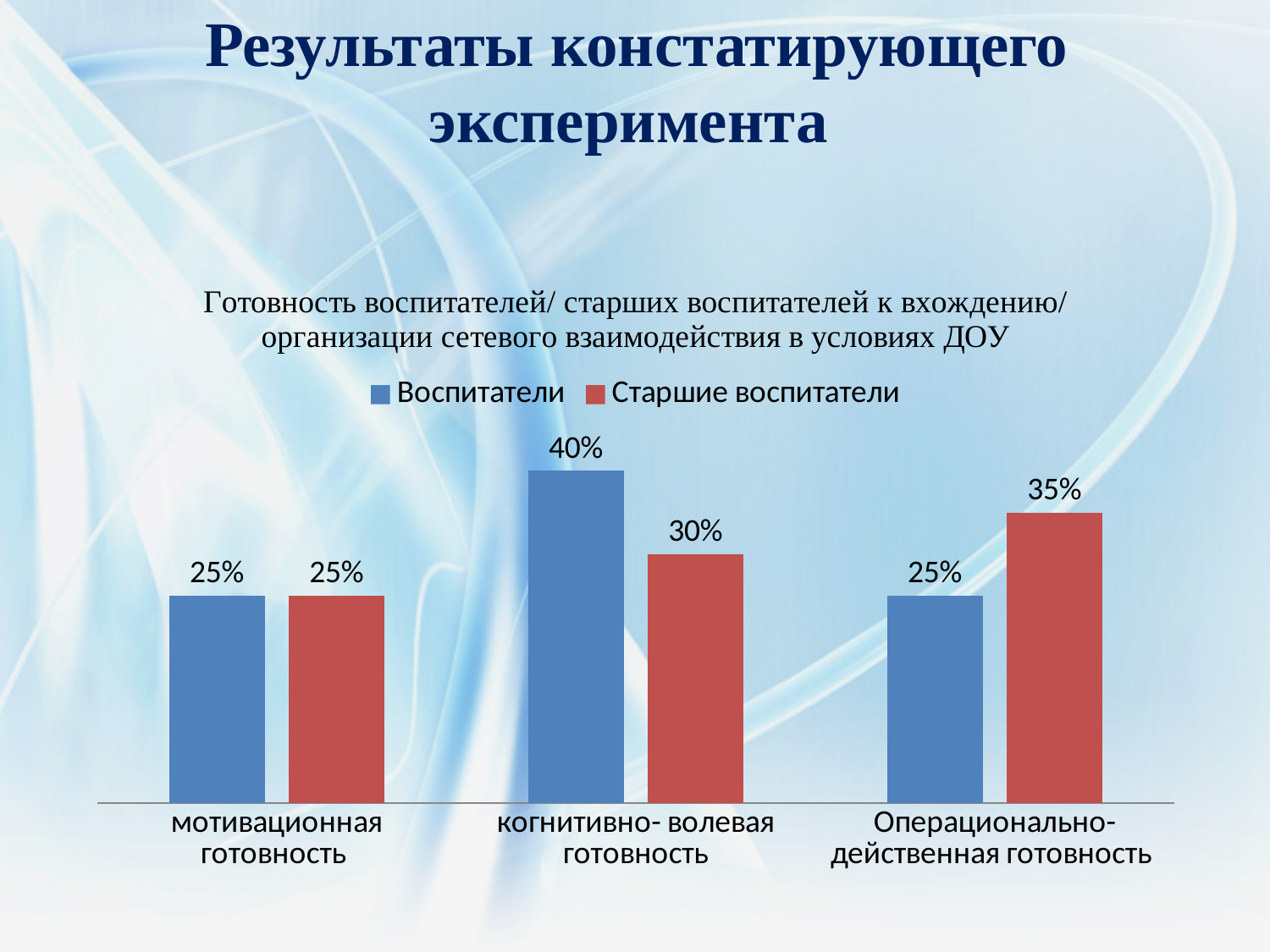
What is the value for Старшие воспитатели in the Операционально-действенная готовность category? 35% How many series does the legend list? 2 How many categories are shown on the x axis? 3 What is the difference between Воспитатели and Старшие воспитатели in the когнитивно-волевая готовность category? 10% What kind of chart is shown on the slide? bar chart In which category does the Старшие воспитатели series have its lowest value? мотивационная готовность What is the value for Старшие воспитатели in the мотивационная готовность category? 25% What is the value for Воспитатели in the Операционально-действенная готовность category? 25% Which series has the larger value in the Операционально-действенная готовность category? Старшие воспитатели Which colour represents the Старшие воспитатели series? red What is the value for Воспитатели in the когнитивно-волевая готовность category? 40% In which category does the Воспитатели series have its highest value? когнитивно-волевая готовность